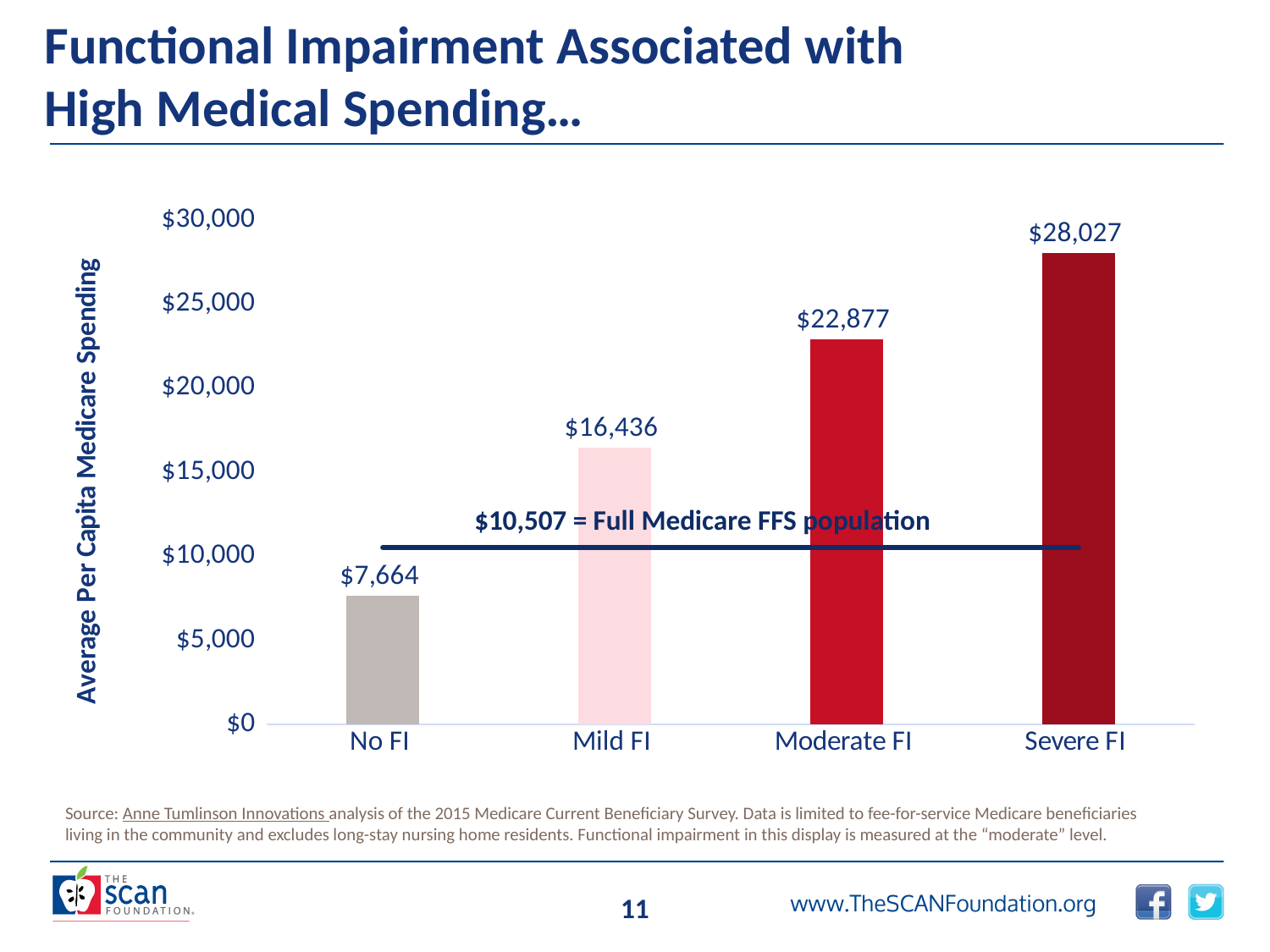
Which category has the highest average per capita Medicare spending? Severe FI What is the average per capita Medicare spending for the Mild FI category? $16,436 What value does the horizontal reference line represent for the full Medicare FFS population? $10,507 What kind of chart is shown on the slide? Bar chart What is the difference in spending between Severe FI and Moderate FI? $5,150 Is the value for No FI greater or less than $10,000? less What is the difference in spending between Mild FI and No FI? $8,772 How many categories are shown on the x axis? 4 What is the average per capita Medicare spending for the Severe FI category? $28,027 What is the average per capita Medicare spending for the No FI category? $7,664 Which has higher spending, Moderate FI or Mild FI? Moderate FI Which category has the lowest average per capita Medicare spending? No FI